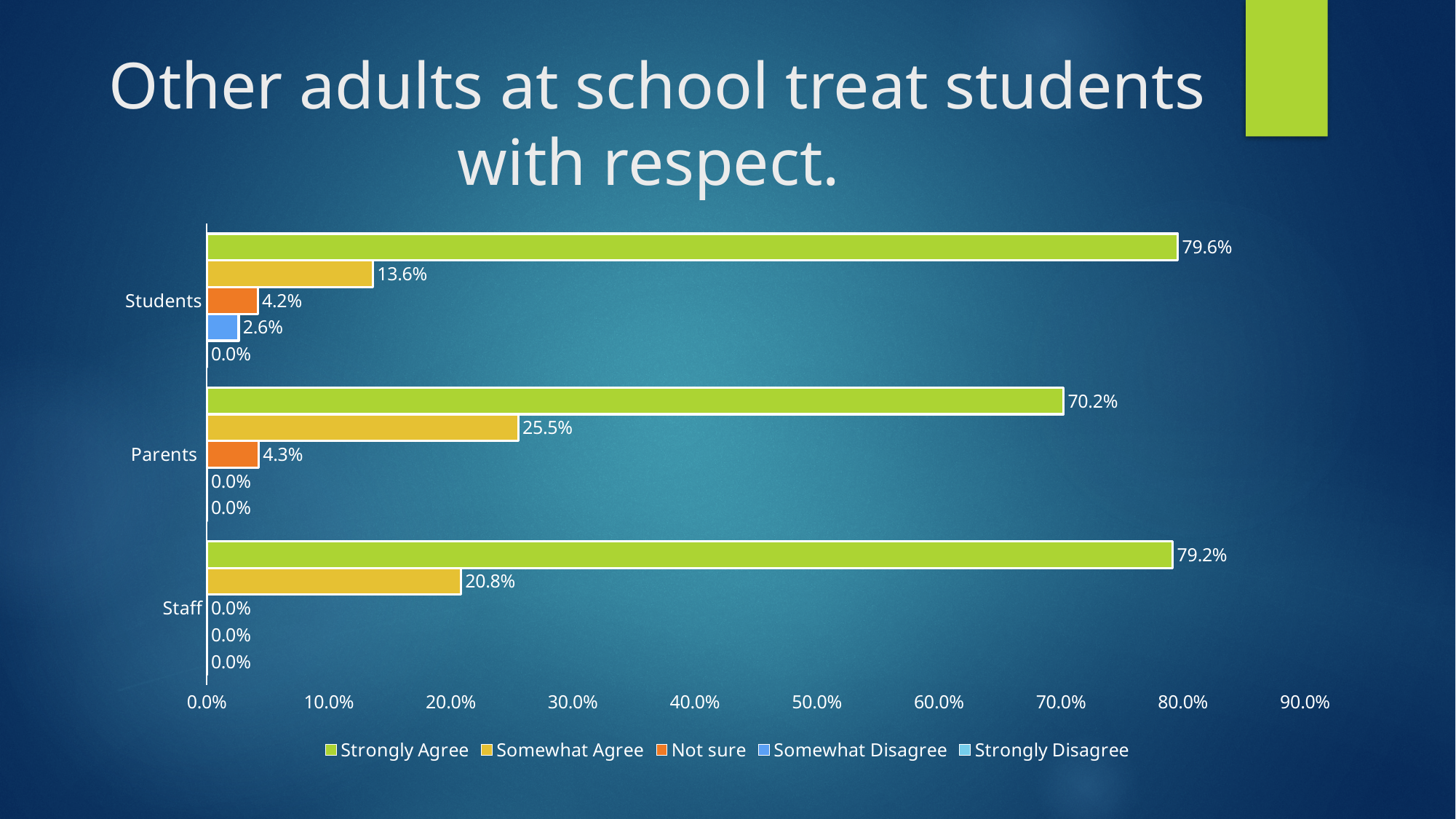
Which group has the highest Strongly Agree percentage? Students What is the Somewhat Agree value for Parents? 25.5% What is the difference between the Somewhat Agree values for Parents and Students? 11.9% What is the Somewhat Disagree value for Students? 2.6% What percentage of Students Strongly Agree that other adults at school treat students with respect? 79.6% Is the Strongly Agree value for Staff larger or smaller than the Strongly Agree value for Parents? larger What kind of chart is shown on the slide? bar chart How many groups are shown on the vertical axis? 3 What is the Somewhat Agree value for Staff? 20.8% How many series does the legend list? 5 Which group has the lowest Strongly Agree percentage? Parents What is the Not sure value for Students? 4.2%